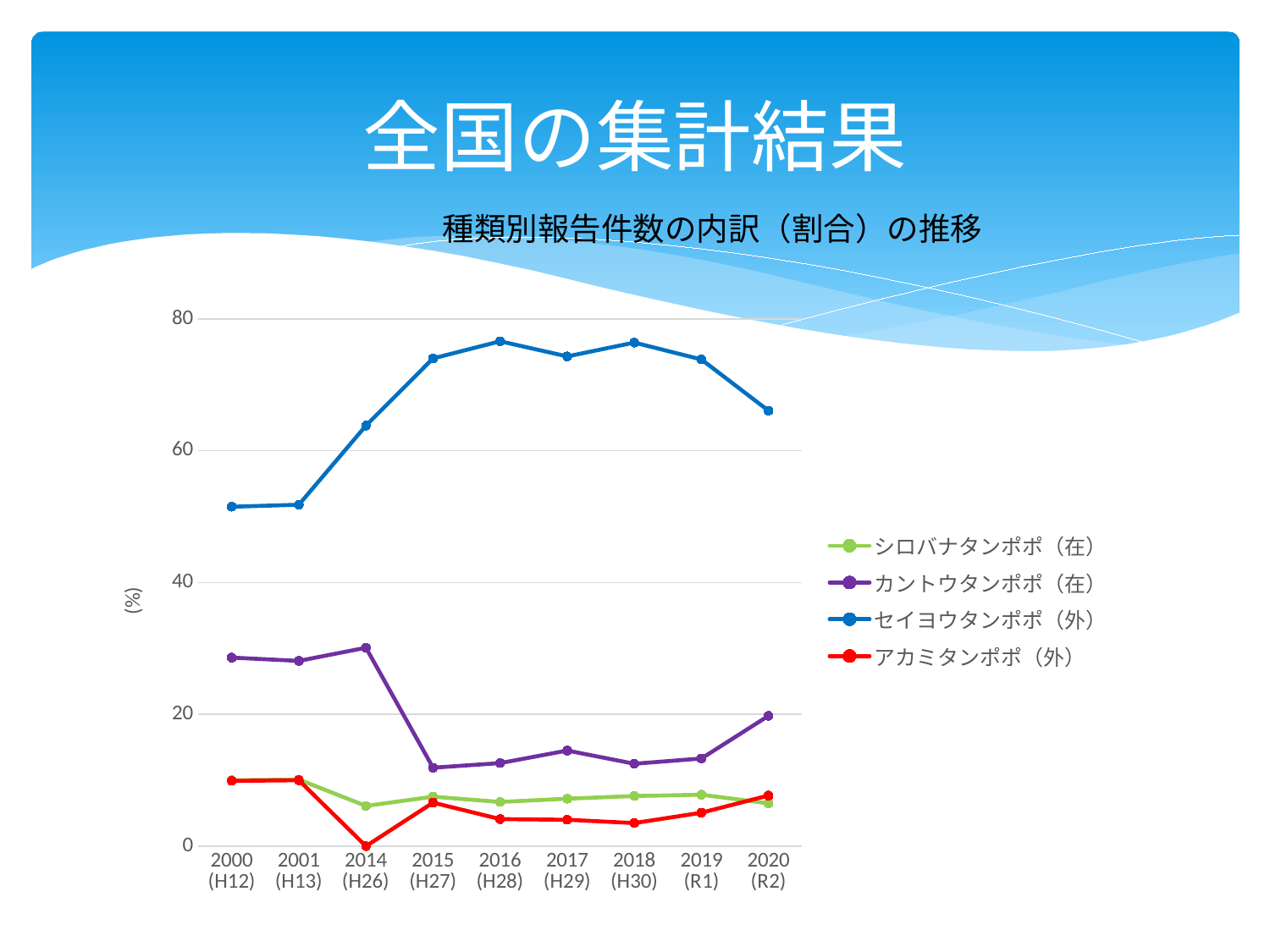
What is the title of the chart? 種類別報告件数の内訳（割合）の推移 What kind of chart is shown on the slide? line chart Which is larger in 2014 (H26): カントウタンポポ（在） or シロバナタンポポ（在）? カントウタンポポ（在） Does the value for カントウタンポポ（在） rise or fall from 2014 (H26) to 2015 (H27)? fall Is the value for セイヨウタンポポ（外） in 2000 (H12) greater or less than 60? less How many series does the legend list? 4 How many points are plotted along the x axis for each series? 9 Is the value for カントウタンポポ（在） in 2015 (H27) greater or less than 20? less Which series has the highest value in 2016 (H28)? セイヨウタンポポ（外） Is the value for セイヨウタンポポ（外） in 2018 (H30) greater or less than 60? greater Which series has the lowest value in 2014 (H26)? アカミタンポポ（外） Does the value for セイヨウタンポポ（外） rise or fall from 2001 (H13) to 2016 (H28)? rise